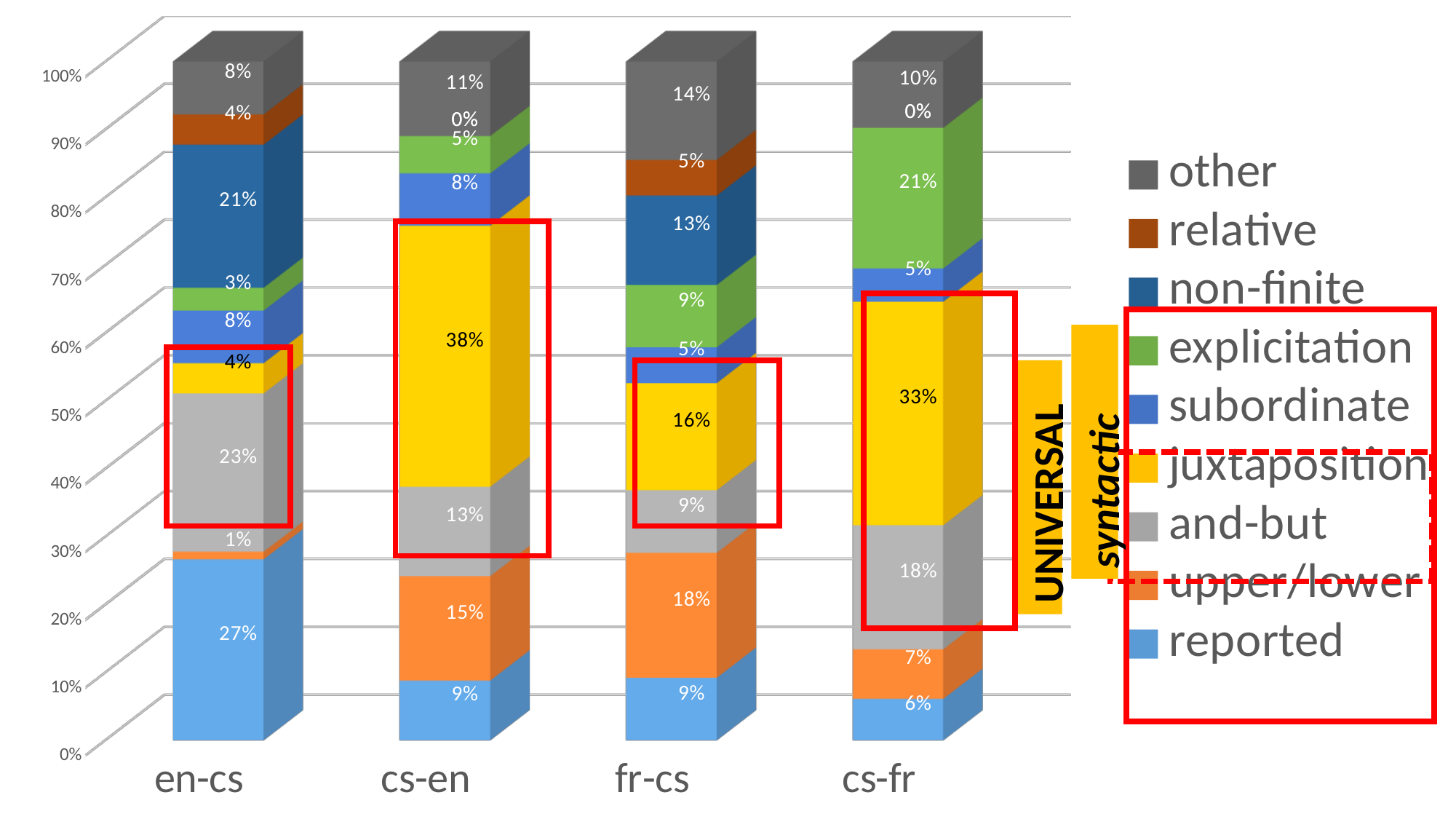
How many series does the legend list? 9 What is the difference between the and-but share for en-cs and for cs-en? 10% Which is larger, the upper/lower share for fr-cs or for cs-fr? fr-cs What kind of chart is shown on the slide? stacked bar chart Which language pair has the highest juxtaposition share? cs-en What is the juxtaposition share for cs-en? 38% How many language-pair categories are shown on the x axis? 4 What is the explicitation share for cs-fr? 21% What is the reported share for en-cs? 27% Which language pair has the lowest reported share? cs-fr What is the non-finite share for fr-cs? 13% Which legend entry is shown in yellow? juxtaposition